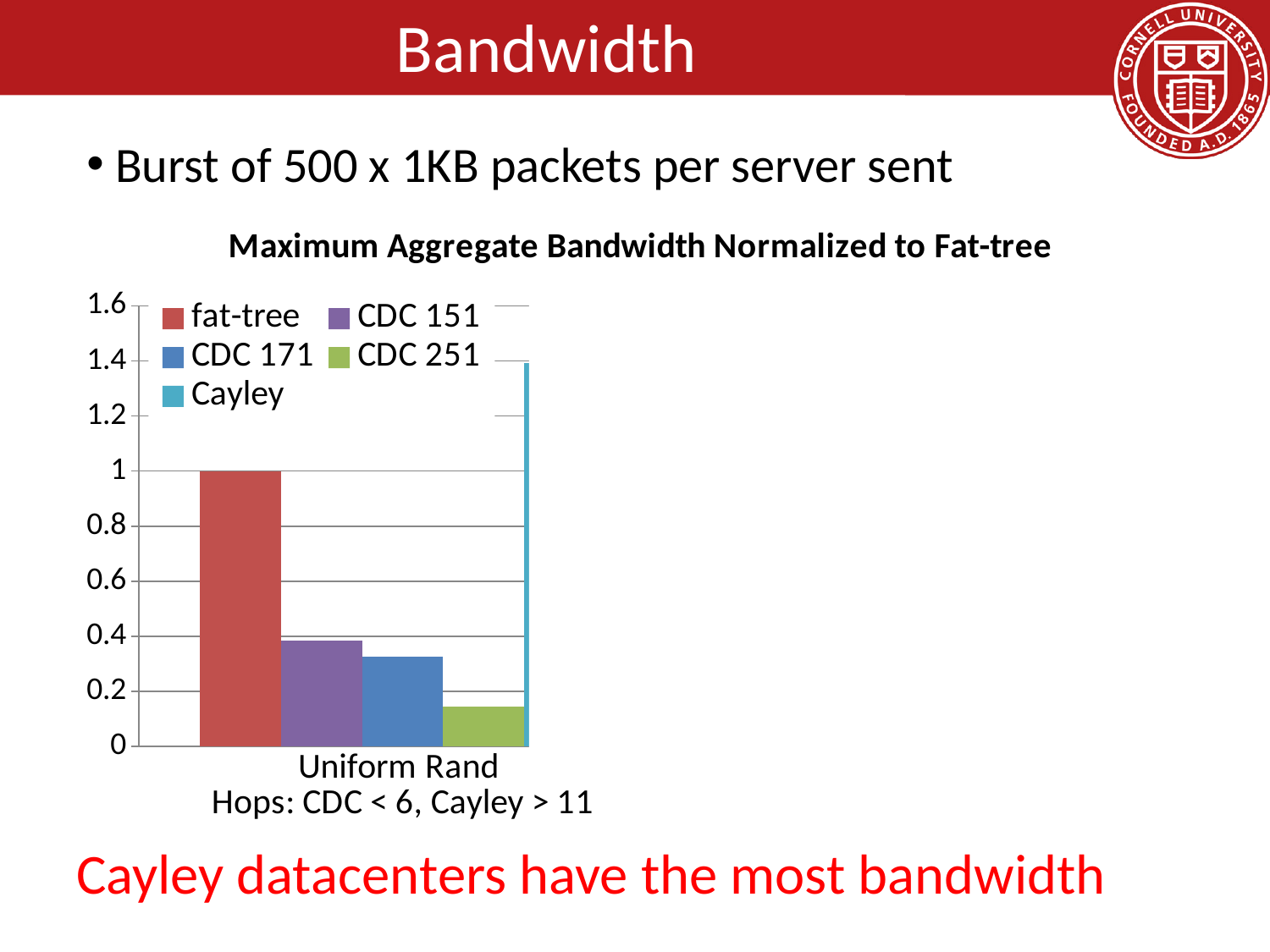
What is the label of the category on the x axis of the chart? Uniform Rand Hops: CDC < 6, Cayley > 11 Which is larger, the value for CDC 151 or the value for CDC 171? CDC 151 Is the value for Cayley greater or less than 1.2? greater What kind of chart is shown on the slide? bar chart Is the value for CDC 251 greater or less than 0.2? less Which series has the highest bar in the chart? Cayley How many series does the chart's legend list? 5 Is the value for CDC 151 greater or less than 0.2? greater Which series has the lowest bar in the chart? CDC 251 How many categories are shown on the x axis of the chart? 1 What is the value for fat-tree in the chart? 1 What is the title of the chart? Maximum Aggregate Bandwidth Normalized to Fat-tree